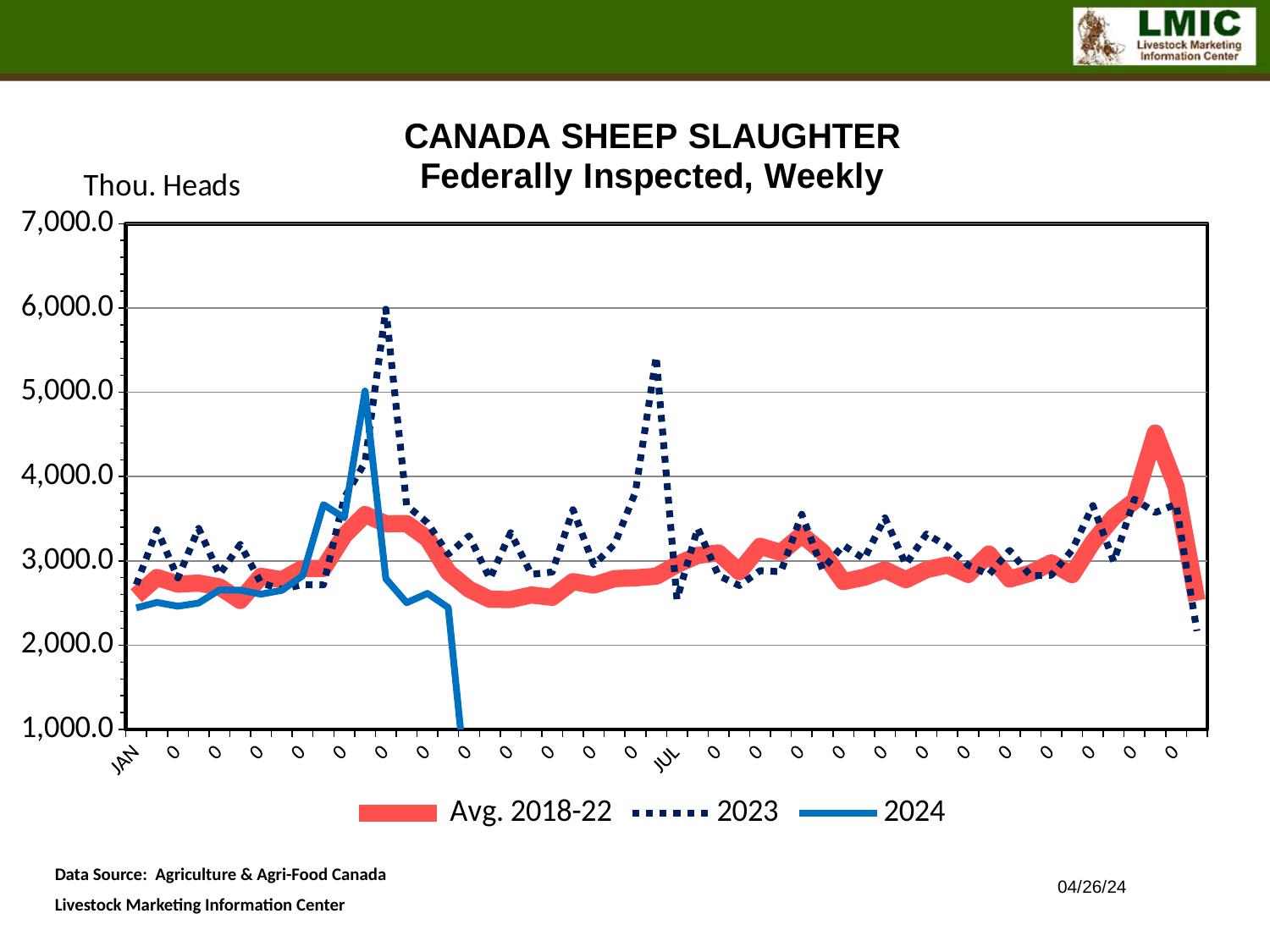
What are the three series listed in the legend? Avg. 2018-22, 2023, 2024 Which series reaches the highest peak on the chart? 2023 Is the highest peak of the 2024 series greater or less than 4,000.0? greater Is the final plotted value of the 2024 series greater or less than 2,000.0? less Is the highest peak of the 2023 series greater or less than 5,000.0? greater How many series does the legend list? 3 Which series drops to the lowest value on the chart? 2024 What unit is shown on the y axis of the chart? Thou. Heads Does the 2024 series rise or fall over its last few plotted weeks? fall What kind of chart is shown on the slide? line chart